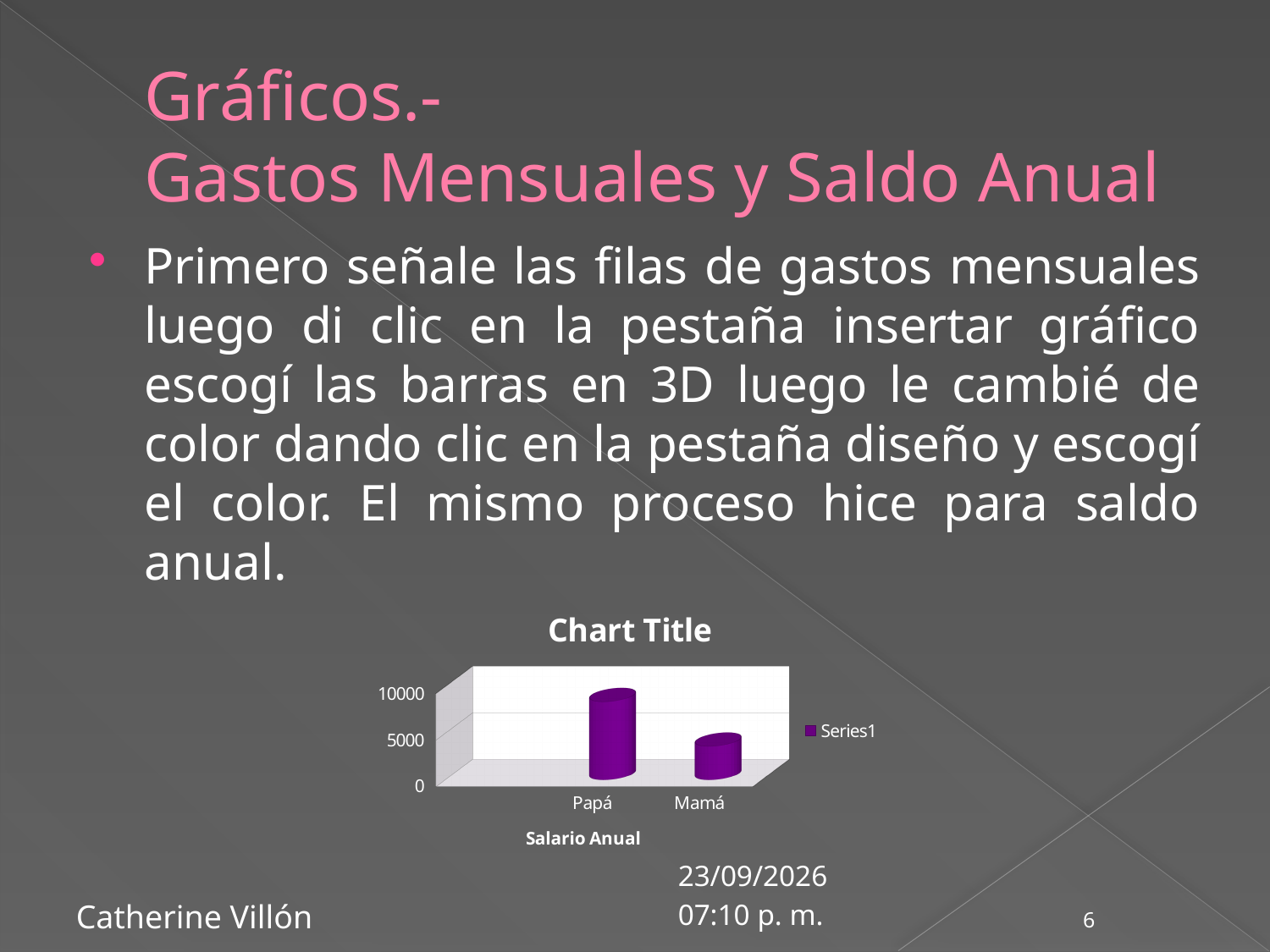
Which category has the highest value on the chart? Papá Which category has the lowest value on the chart? Mamá How many series does the chart legend list? 1 How many categories are plotted on the chart? 2 Is the value for Papá greater or less than 5000? greater Which is larger, the value for Papá or the value for Mamá? Papá What kind of chart is shown on the slide? bar chart Is the value for Papá greater or less than 10000? less What is the title of the chart? Chart Title What is the name of the series shown in the chart legend? Series1 Is the value for Mamá greater or less than 5000? less